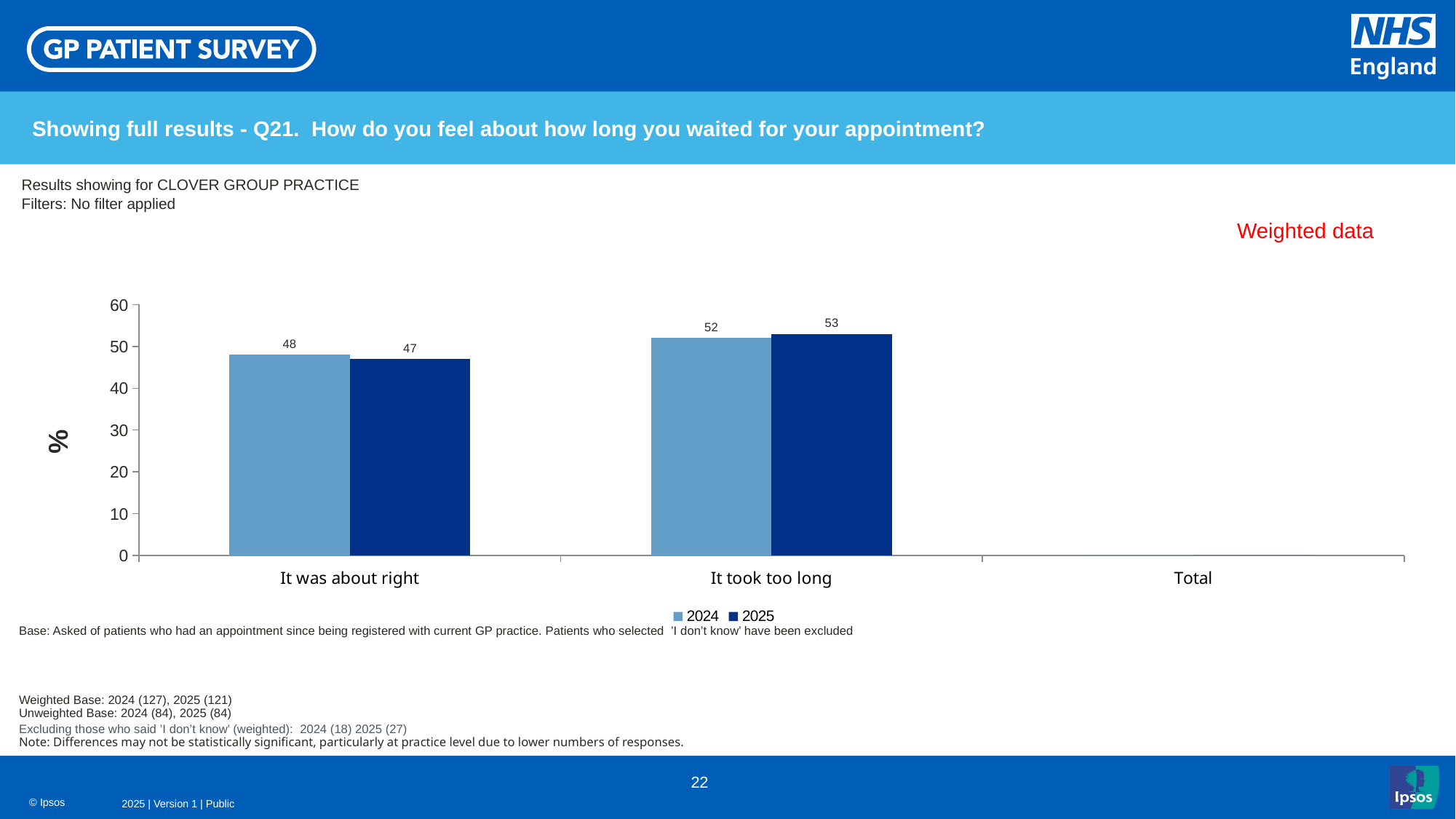
What is the 2025 value for "It was about right"? 47 What is the difference between the 2024 and 2025 values for "It took too long"? 1 How many series does the legend list? 2 Which category has the highest 2025 value? It took too long What is the 2024 value for "It took too long"? 52 Which category has the lowest 2024 value? It was about right What kind of chart is shown on the slide? Bar chart Is the 2025 value for "It took too long" greater or less than 50? greater Which is larger for "It was about right": the 2024 value or the 2025 value? 2024 What is the 2024 value for "It was about right"? 48 What is the 2025 value for "It took too long"? 53 What is the label on the vertical axis of the chart? %